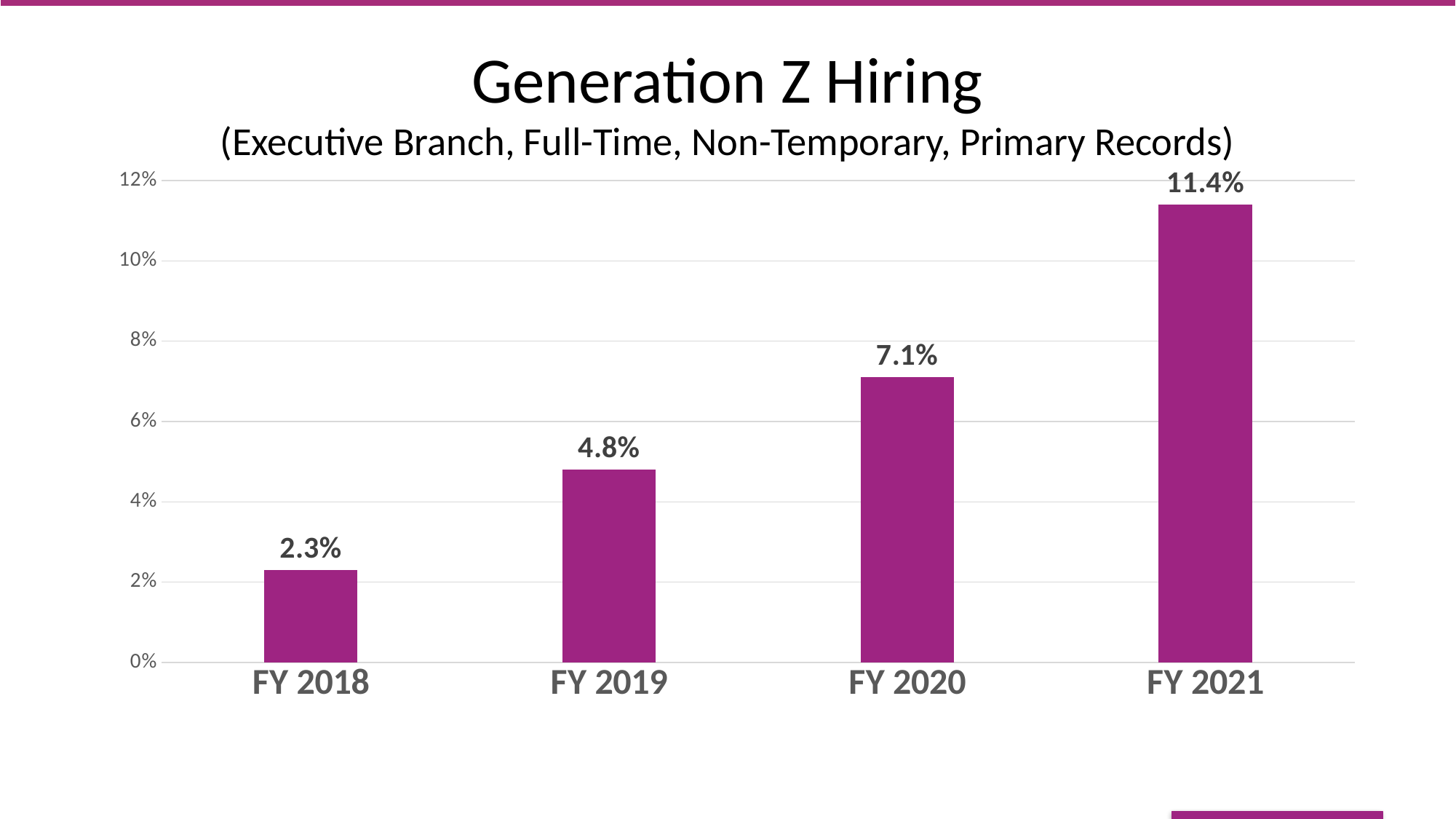
Which is larger, the value for FY 2019 or the value for FY 2020? FY 2020 What is the difference between the FY 2020 and FY 2019 values? 2.3% Which fiscal year has the lowest Generation Z hiring value? FY 2018 Which fiscal year has the highest Generation Z hiring value? FY 2021 How many fiscal years are shown on the chart? 4 What kind of chart is shown on the slide? Bar chart What is the Generation Z hiring value for FY 2020? 7.1% What is the Generation Z hiring value for FY 2018? 2.3% What is the difference between the FY 2021 and FY 2018 values? 9.1% What is the Generation Z hiring value for FY 2021? 11.4% Do the values rise or fall from FY 2018 to FY 2021? Rise Is the value for FY 2019 greater or less than 4%? greater